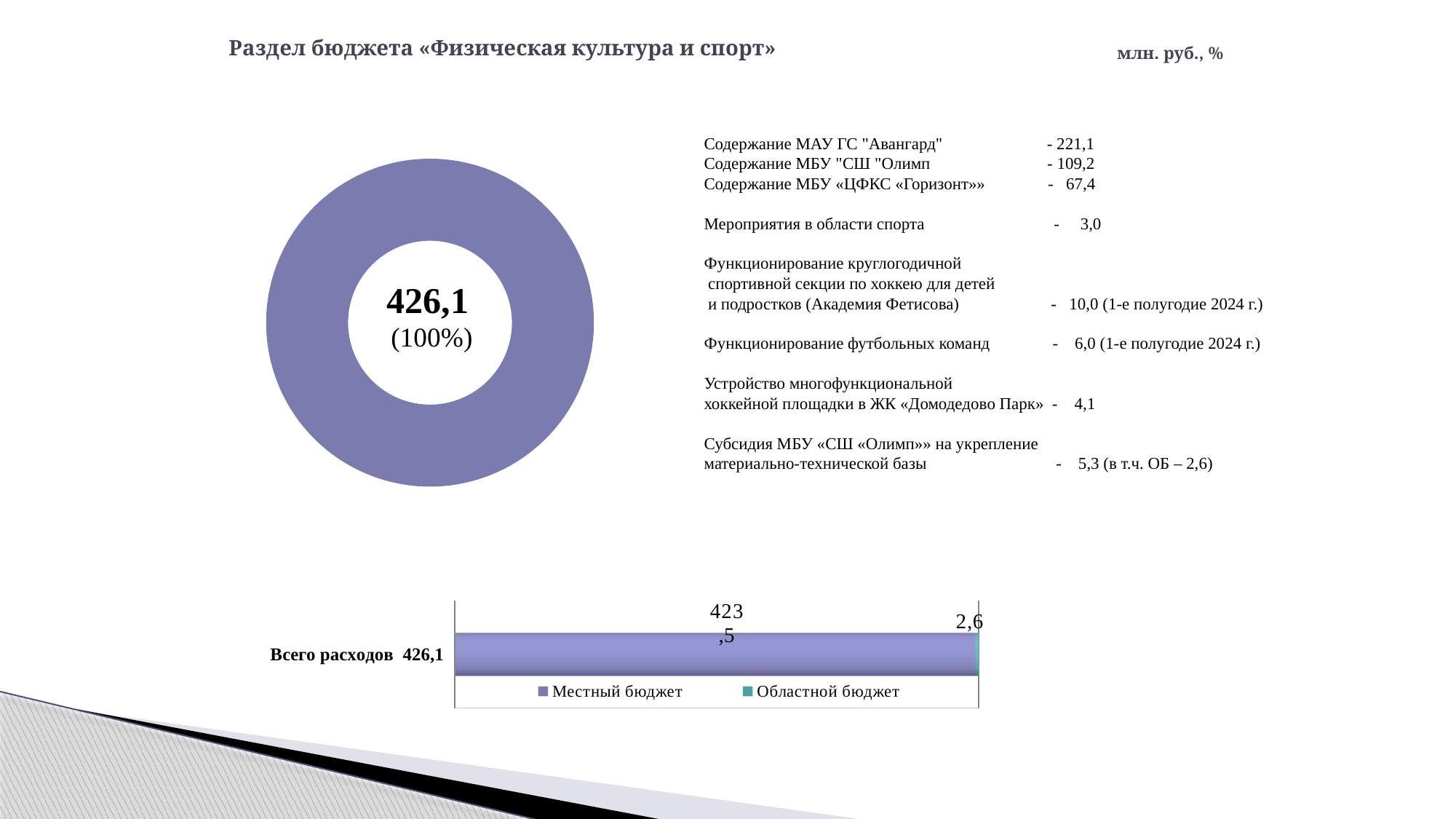
What kind of chart is the chart at the bottom of the slide? Bar chart In the bar chart at the bottom, what is the value for Местный бюджет? 423,5 In the bar chart at the bottom, how many categories are plotted? 1 In the donut chart at the top left, what percentage is shown in the centre? 100% What kind of chart is the chart at the top left of the slide? Donut chart In the donut chart at the top left, what value is printed in the centre? 426,1 In the bar chart at the bottom, what is the difference between the Местный бюджет and Областной бюджет values? 420,9 In the bar chart at the bottom, what is the value for Областной бюджет? 2,6 In the bar chart at the bottom, what is the total of the stacked bar for Всего расходов? 426,1 In the bar chart at the bottom, which series has the larger value, Местный бюджет or Областной бюджет? Местный бюджет In the bar chart at the bottom, how many series does the legend list? 2 In the bar chart at the bottom, what is the label of the category on the vertical axis? Всего расходов 426,1